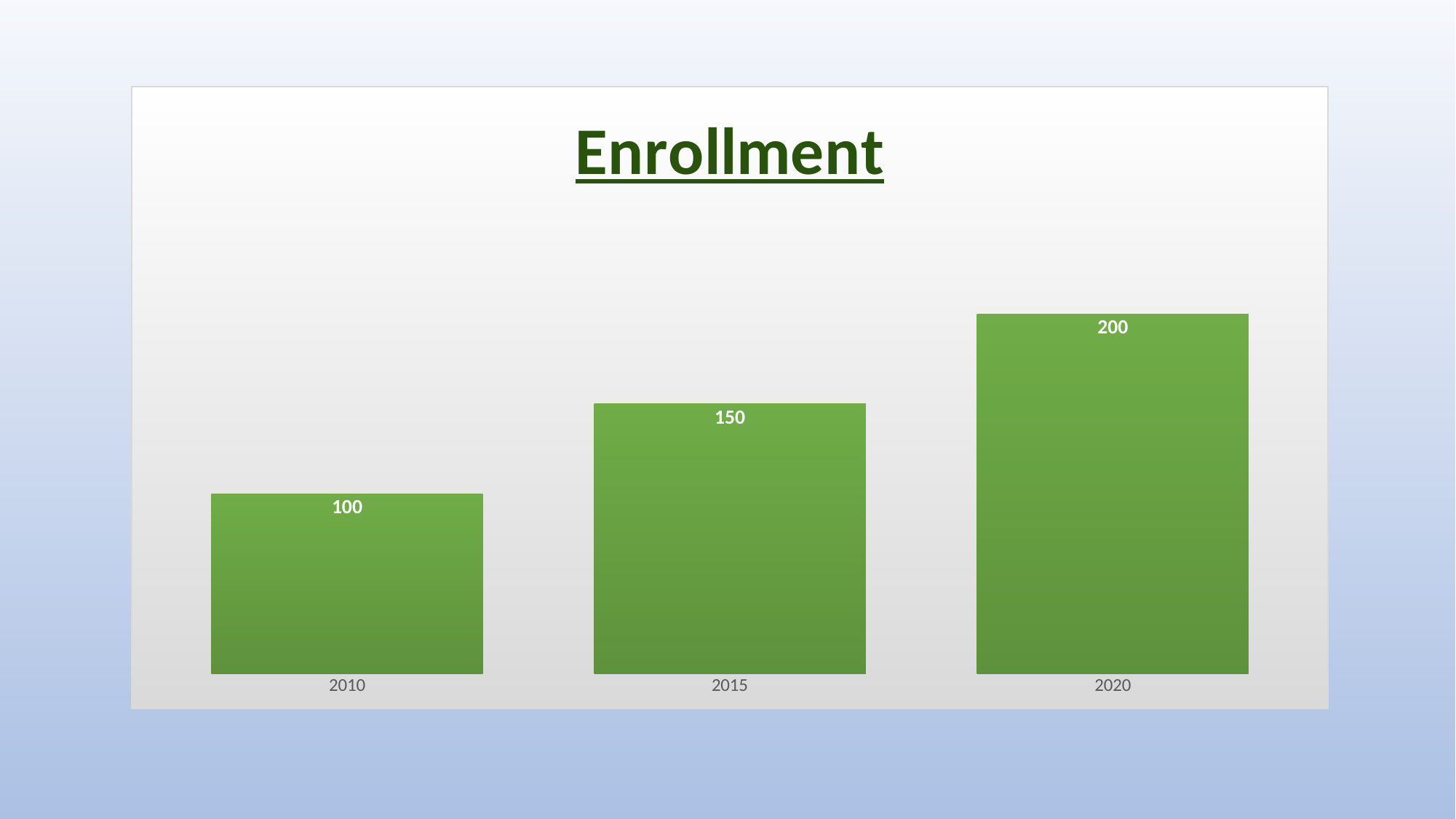
What is the difference in enrollment between 2015 and 2010? 50 Which year has the highest enrollment? 2020 How many years are shown on the x axis? 3 Which year has a larger enrollment, 2015 or 2020? 2020 What is the title of the chart? Enrollment What is the enrollment value for 2015? 150 What is the difference in enrollment between 2020 and 2010? 100 Which year has the lowest enrollment? 2010 What is the enrollment value for 2010? 100 What is the enrollment value for 2020? 200 Do the enrollment values rise or fall from 2010 to 2020? rise What kind of chart is shown on the slide? bar chart